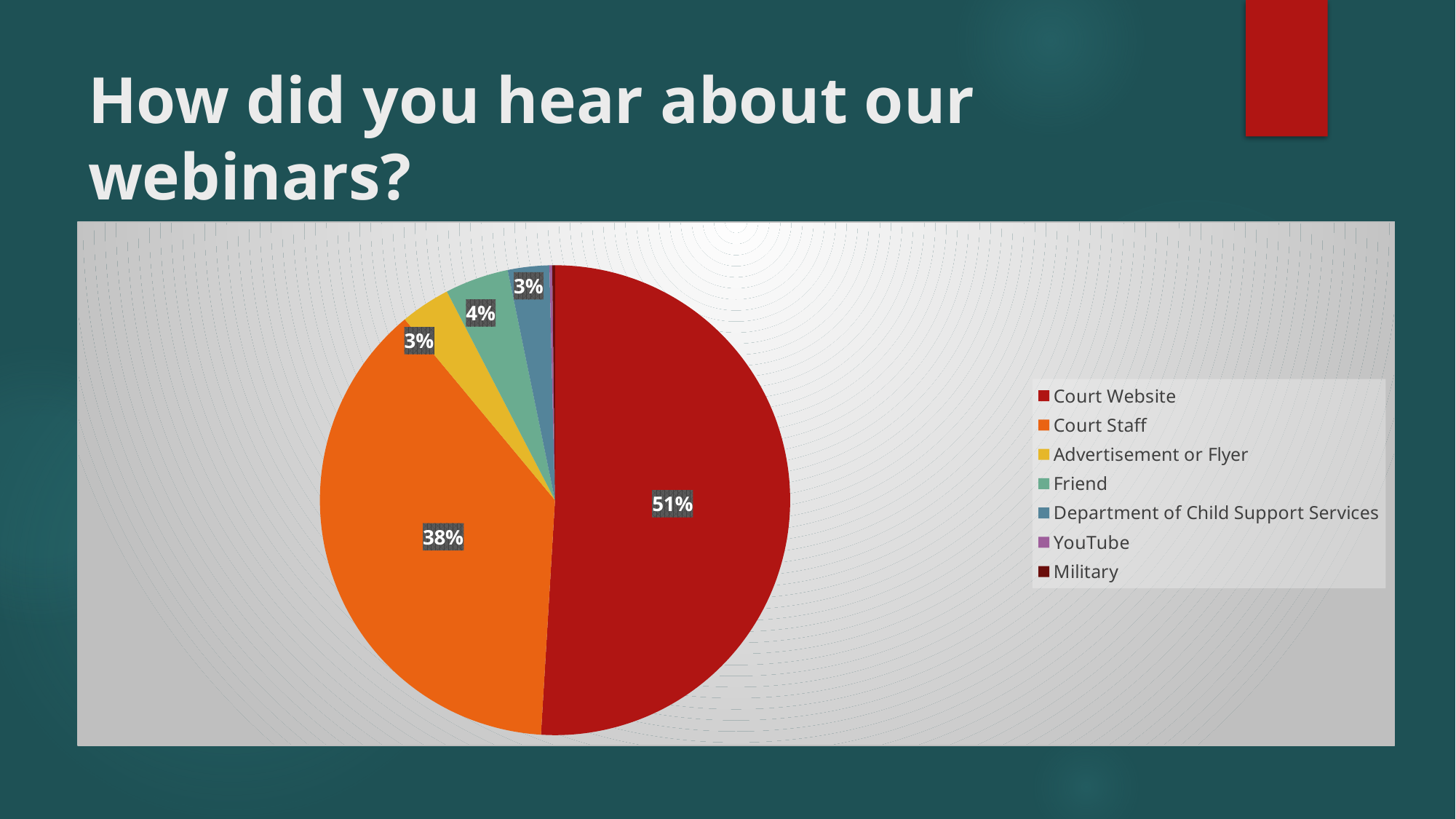
What is the title of the slide containing the chart? How did you hear about our webinars? What kind of chart is shown on the slide? pie chart How many categories does the legend list? 7 What share of the pie is Department of Child Support Services? 3% What colour is the Court Staff slice? orange Which category has the largest slice of the pie? Court Website What share of the pie is Court Staff? 38% What is the difference in percentage points between Court Website and Court Staff? 13 What share of the pie is Advertisement or Flyer? 3% What share of the pie is Friend? 4% What share of the pie is Court Website? 51% Which is larger, the Friend slice or the Advertisement or Flyer slice? Friend